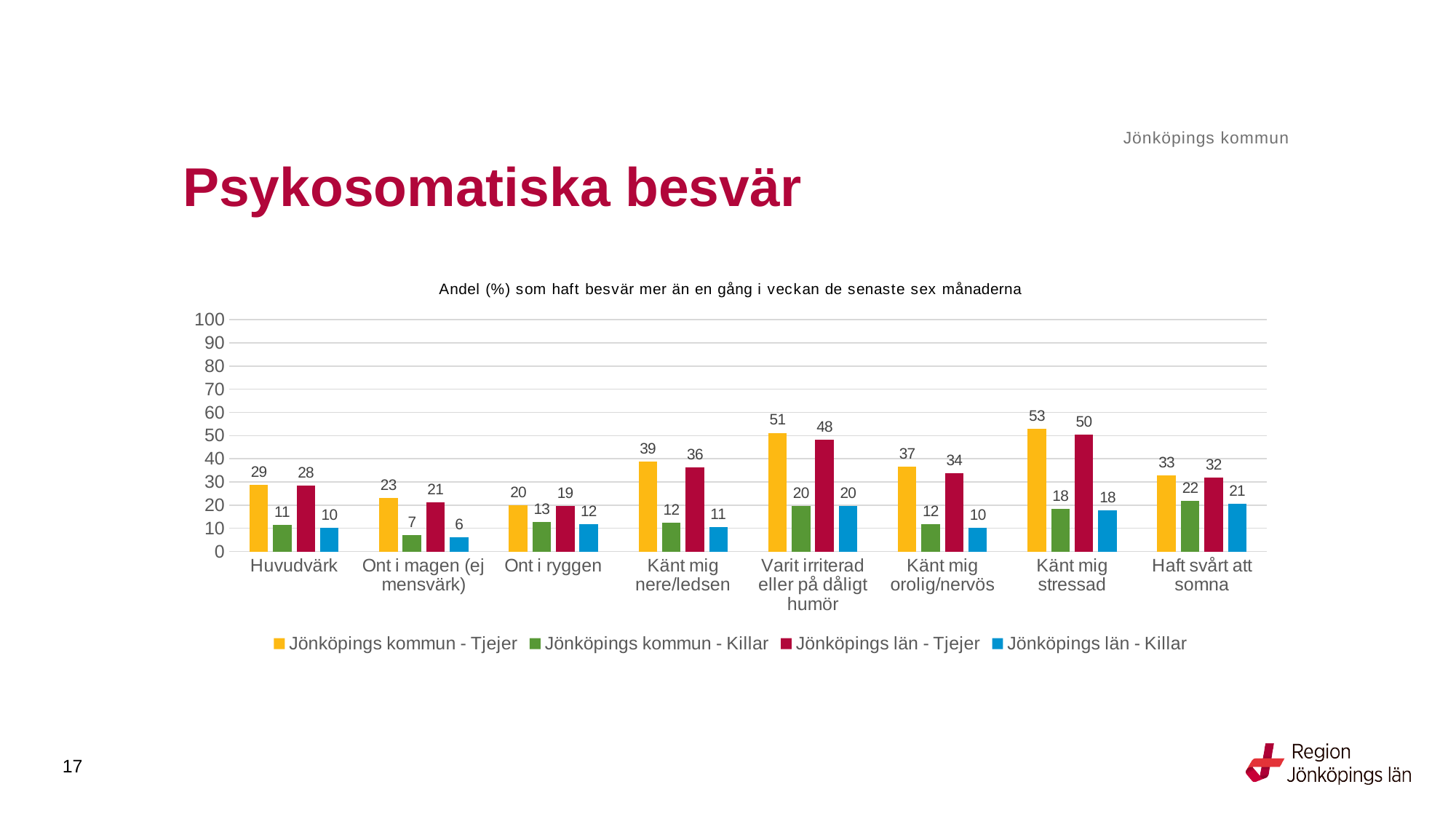
How many series does the legend list? 4 What is the subtitle printed above the chart? Andel (%) som haft besvär mer än en gång i veckan de senaste sex månaderna What kind of chart is shown on the slide? Bar chart What is the value for Jönköpings kommun - Killar for Haft svårt att somna? 22 Which category has the highest value for Jönköpings län - Tjejer? Känt mig stressad Which is larger for Känt mig nere/ledsen: Jönköpings kommun - Tjejer or Jönköpings län - Tjejer? Jönköpings kommun - Tjejer What is the difference between Jönköpings kommun - Tjejer and Jönköpings kommun - Killar for Varit irriterad eller på dåligt humör? 31 How many categories are shown on the x axis? 8 What is the value for Jönköpings kommun - Tjejer for Känt mig stressad? 53 Is the value for Jönköpings län - Tjejer for Känt mig stressad greater or less than 40? greater Which category has the lowest value for Jönköpings kommun - Killar? Ont i magen (ej mensvärk) What is the value for Jönköpings län - Killar for Ont i magen (ej mensvärk)? 6